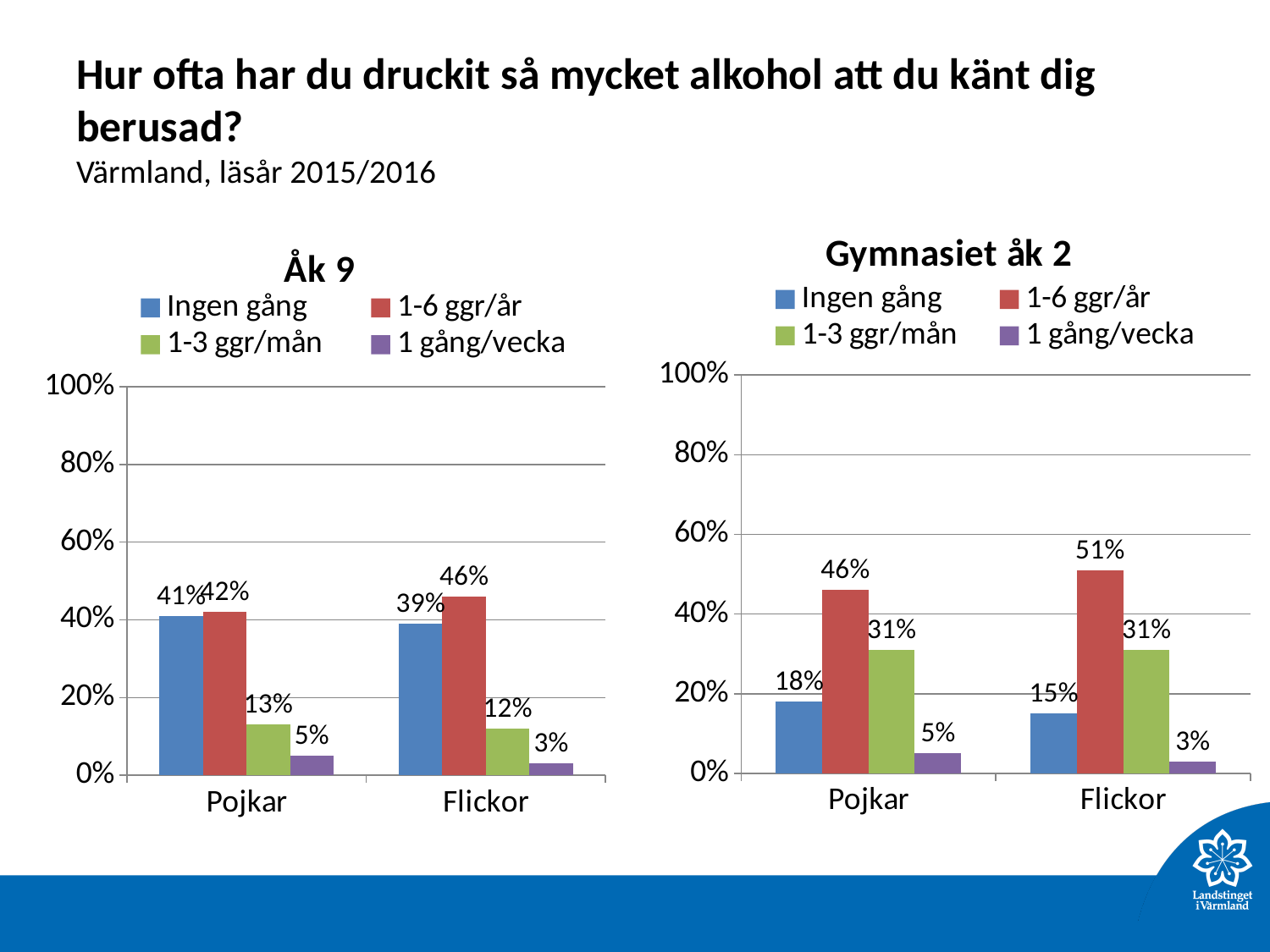
In the 'Åk 9' chart, what is the value for 'Ingen gång' for Pojkar? 41% In the 'Åk 9' chart, which series has the lowest value for Pojkar? 1 gång/vecka In the 'Åk 9' chart, what is the value for '1-6 ggr/år' for Flickor? 46% What kind of chart is the 'Gymnasiet åk 2' chart? Bar chart How many series does the legend of the 'Åk 9' chart list? 4 In the 'Gymnasiet åk 2' chart, what is the value for '1-3 ggr/mån' for Pojkar? 31% In the 'Åk 9' chart, which is larger: '1-3 ggr/mån' for Pojkar or '1-3 ggr/mån' for Flickor? Pojkar In the 'Gymnasiet åk 2' chart, what is the value for '1 gång/vecka' for Flickor? 3% How many categories are shown on the x axis of the 'Gymnasiet åk 2' chart? 2 In the 'Gymnasiet åk 2' chart, what is the difference between the '1-6 ggr/år' values for Flickor and Pojkar? 5% In the 'Gymnasiet åk 2' chart, is the value for 'Ingen gång' for Pojkar greater or less than 20%? less In the 'Gymnasiet åk 2' chart, which series has the highest value for Flickor? 1-6 ggr/år